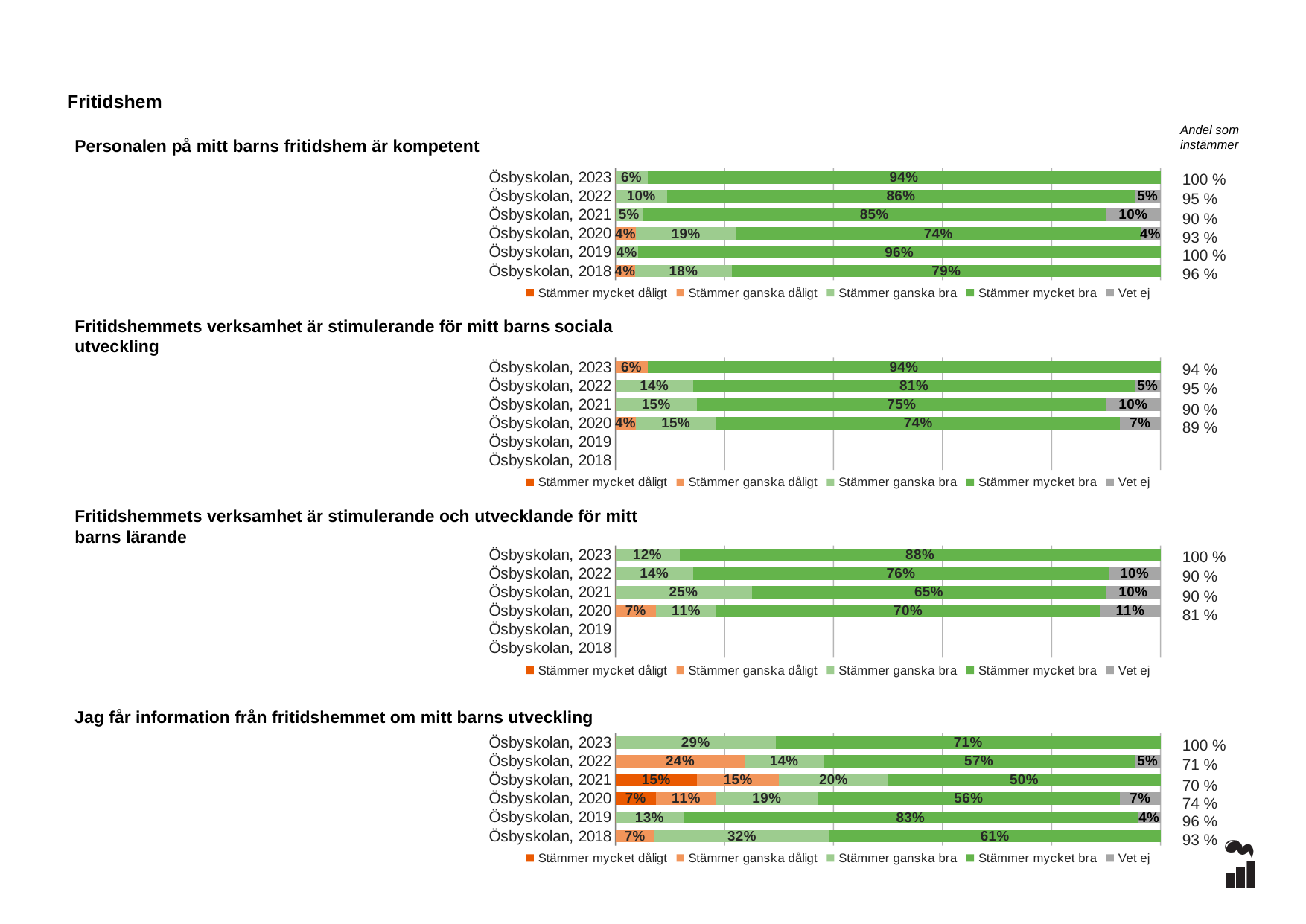
In the chart 'Fritidshemmets verksamhet är stimulerande för mitt barns sociala utveckling', what is the 'Stämmer ganska bra' value for Ösbyskolan, 2022? 14% In the chart 'Jag får information från fritidshemmet om mitt barns utveckling', which year has the highest 'Stämmer mycket bra' value? Ösbyskolan, 2019 In the chart 'Fritidshemmets verksamhet är stimulerande och utvecklande för mitt barns lärande', what is the difference between the 'Stämmer mycket bra' values for Ösbyskolan, 2023 and Ösbyskolan, 2022? 12% In the chart 'Personalen på mitt barns fritidshem är kompetent', what is the 'Vet ej' value for Ösbyskolan, 2021? 10% How many year categories are listed on the y axis of the chart 'Personalen på mitt barns fritidshem är kompetent'? 6 In the chart 'Personalen på mitt barns fritidshem är kompetent', what is the 'Stämmer mycket bra' value for Ösbyskolan, 2019? 96% In the chart 'Personalen på mitt barns fritidshem är kompetent', which year has the lowest 'Stämmer mycket bra' value? Ösbyskolan, 2020 In the chart 'Fritidshemmets verksamhet är stimulerande för mitt barns sociala utveckling', how many series does the legend list? 5 In the chart 'Jag får information från fritidshemmet om mitt barns utveckling', which is larger: the 'Stämmer ganska bra' value for Ösbyskolan, 2018 or for Ösbyskolan, 2023? Ösbyskolan, 2018 In the chart 'Fritidshemmets verksamhet är stimulerande och utvecklande för mitt barns lärande', what is the 'Stämmer mycket bra' value for Ösbyskolan, 2021? 65% In the chart 'Jag får information från fritidshemmet om mitt barns utveckling', what is the 'Stämmer mycket dåligt' value for Ösbyskolan, 2021? 15% What kind of chart is used for 'Jag får information från fritidshemmet om mitt barns utveckling'? Stacked bar chart